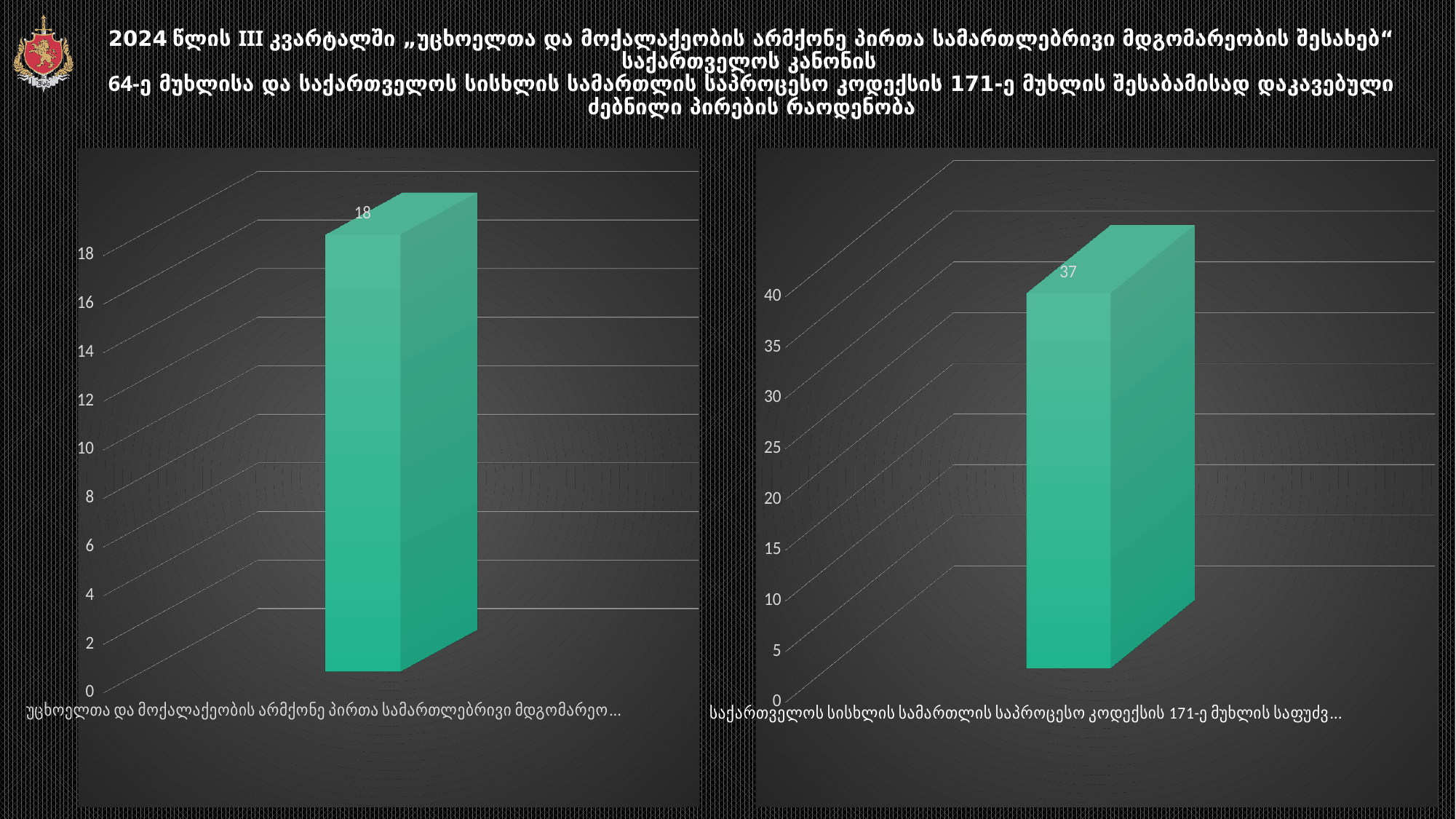
What is the difference between the value on the right chart (37) and the value on the left chart (18)? 19 What colour are the bars on both charts? green What kind of chart is the left chart? bar chart What is the highest tick value shown on the vertical axis of the right chart? 40 On the right chart, is the value of the bar greater or less than 30? greater How many bars are plotted on the right chart? 1 On the left chart, what value is shown on the data label of the bar? 18 How many bars are plotted on the left chart? 1 On the right chart, what value is shown on the data label of the bar? 37 What kind of chart is the right chart? bar chart On the left chart, is the value of the bar greater or less than 10? greater Which chart shows the larger value, the left chart or the right chart? the right chart